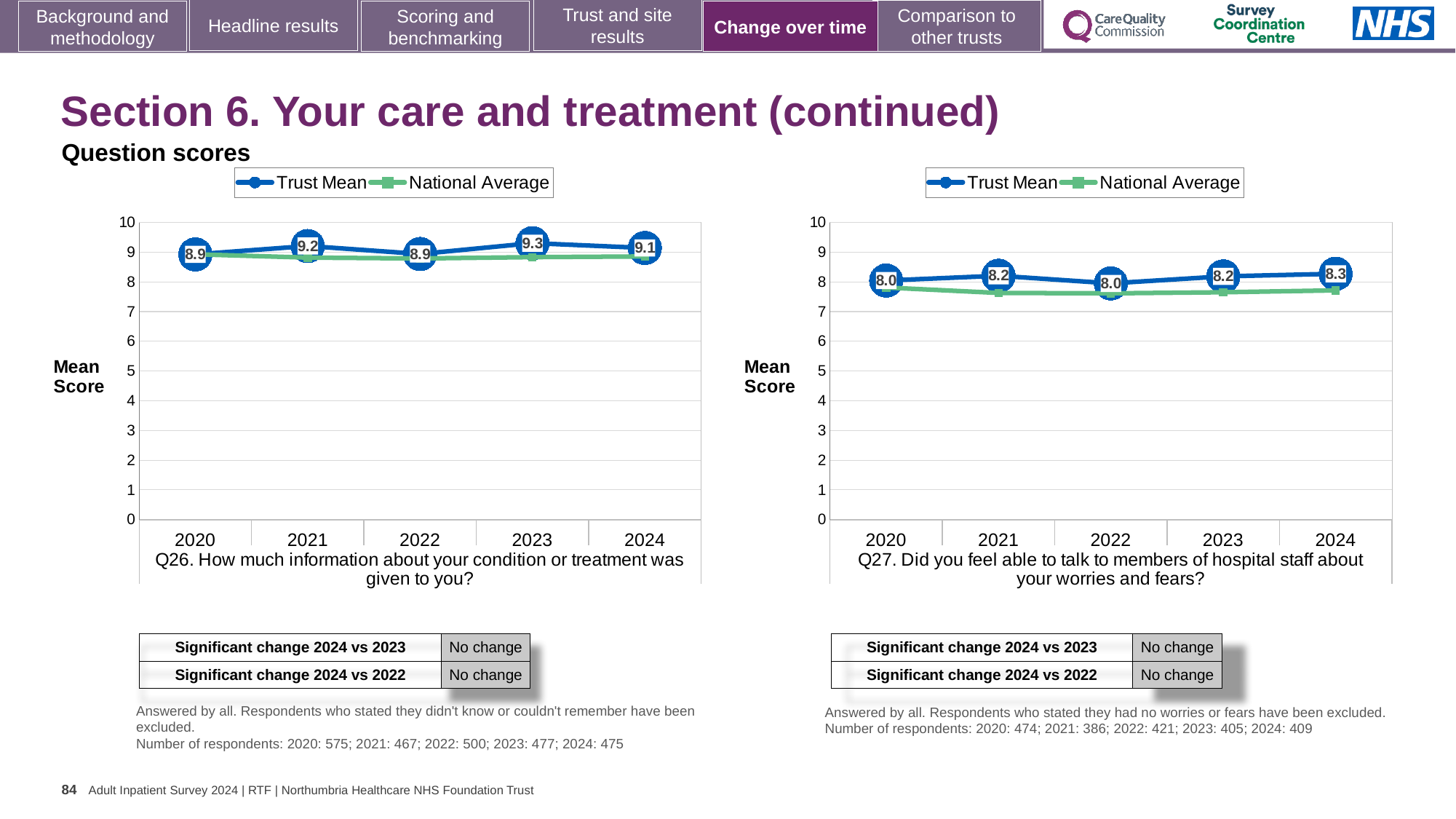
How many series does the legend of the Q27 chart on the right list? 2 In the Q27 chart on the right, what is the Trust Mean score for 2024? 8.3 In the Q27 chart on the right, what is the difference between the Trust Mean scores for 2024 and 2021? 0.1 In the Q27 chart on the right, is the National Average value for 2020 greater or less than 8? less In the Q27 chart on the right, which year has the highest Trust Mean score? 2024 In the Q26 chart on the left, what is the Trust Mean score for 2023? 9.3 In the Q26 chart on the left, what is the difference between the Trust Mean scores for 2023 and 2020? 0.4 In the Q26 chart on the left, what is the Trust Mean score for 2021? 9.2 How many years are plotted on the x axis of the Q26 chart on the left? 5 In the Q26 chart on the left, is the Trust Mean score higher in 2021 or in 2024? 2021 In the Q27 chart on the right, what is the Trust Mean score for 2020? 8.0 In the Q26 chart on the left, which year has the highest Trust Mean score? 2023